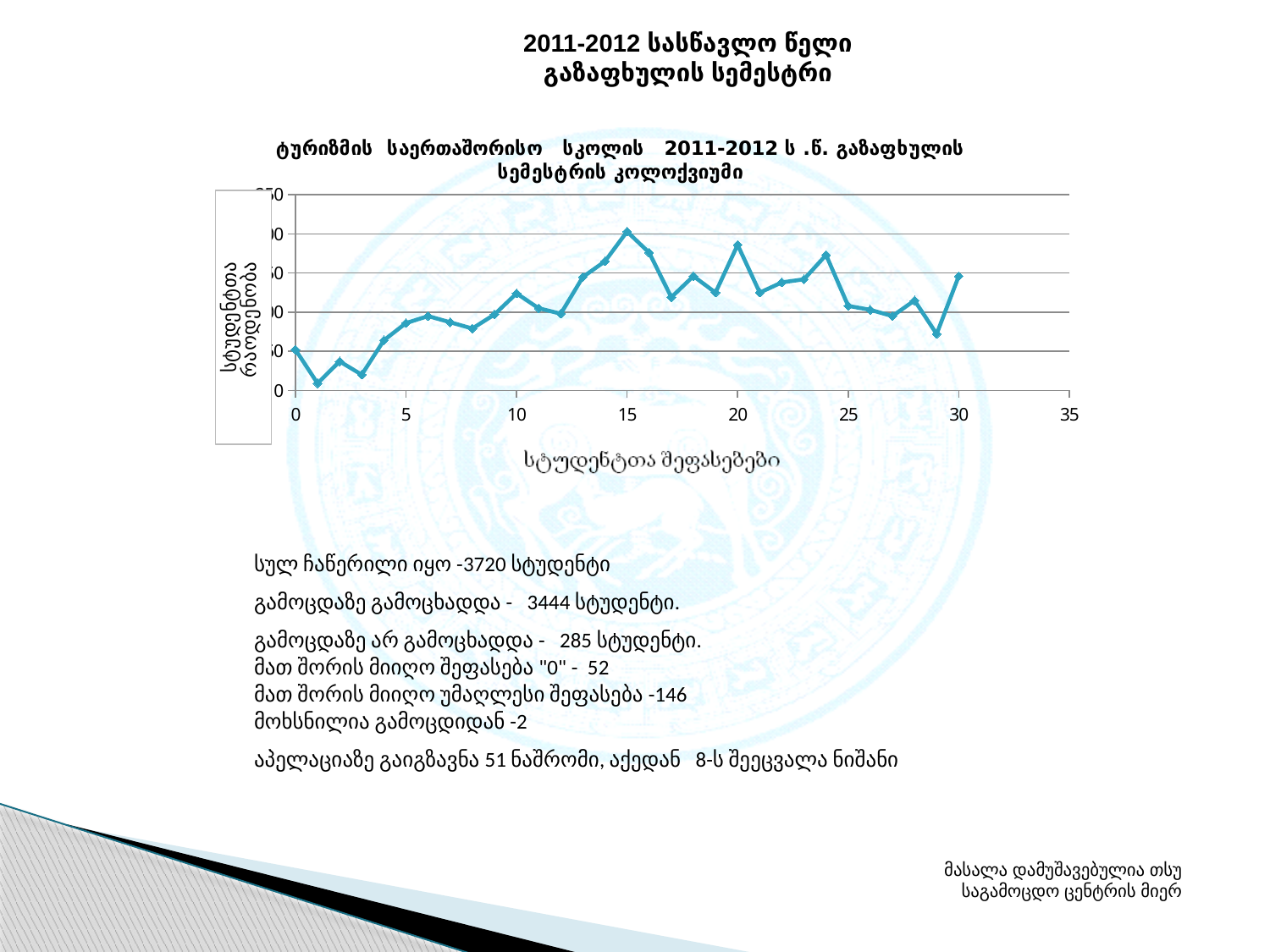
What is the label of the x axis of the chart? სტუდენტთა შეფასებები Which is larger, the value at x = 15 or the value at x = 20? x = 15 What kind of chart is shown on the slide? line chart At which x-axis value does the line reach its lowest point? 1 Do the values generally rise or fall along the x axis from 0 to 15? rise Is the value at x = 20 greater or less than 150? greater Which is larger, the value at x = 2 or the value at x = 12? x = 12 How many data points are plotted on the line? 31 At which x-axis value does the line reach its highest point? 15 Is the value at x = 15 greater or less than 150? greater Is the value at x = 1 greater or less than 50? less